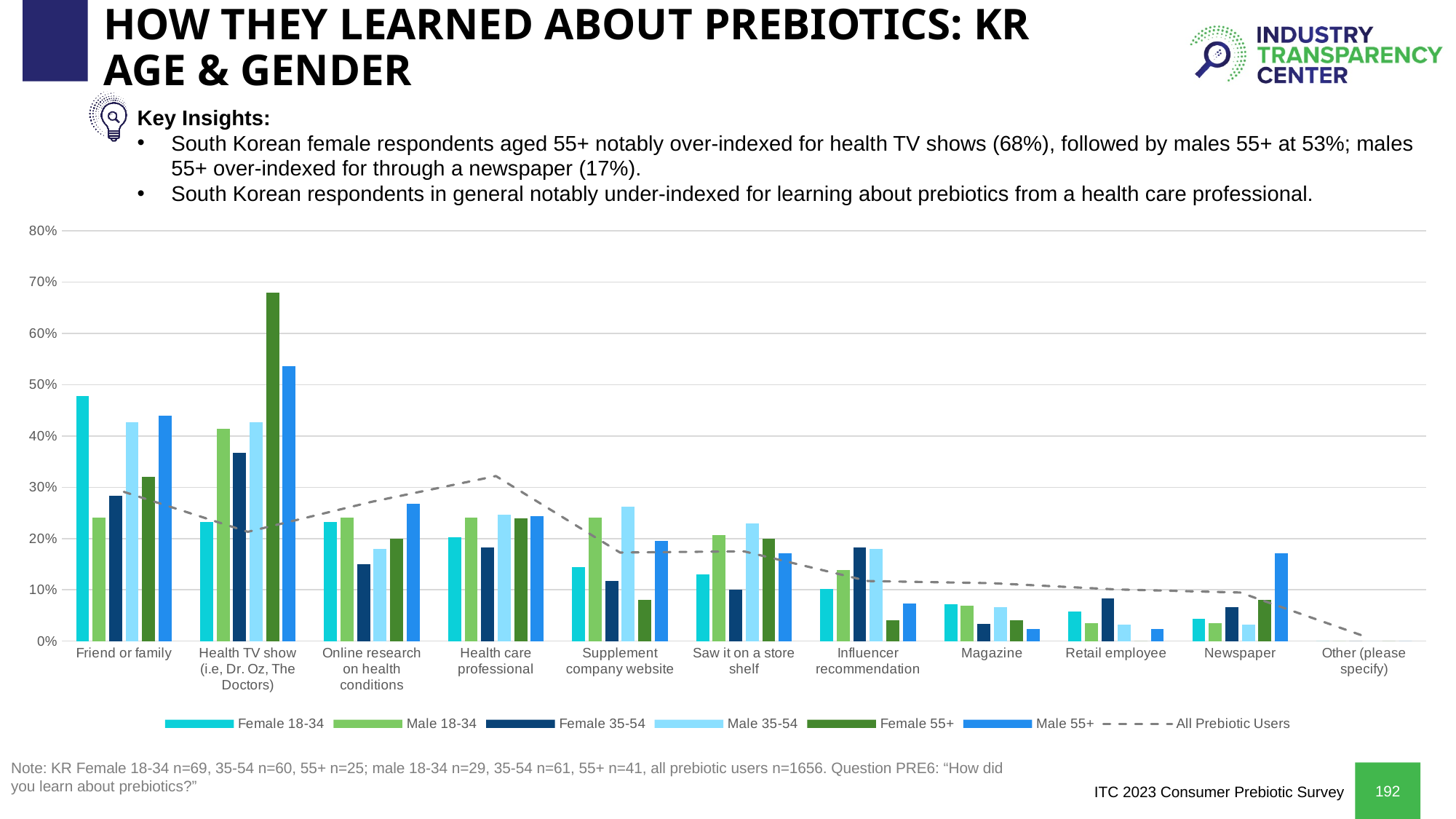
In which category is the Female 55+ bar highest? Health TV show (i.e, Dr. Oz, The Doctors) What is the value for Female 55+ in the Health TV show category? 68% Is the value for Female 18-34 in the Friend or family category greater or less than 40%? greater In which category is the Female 18-34 bar highest? Friend or family What is the value for Male 55+ in the Health TV show category? 53% What is the value for Male 55+ in the Newspaper category? 17% Which series is shown as a dashed line rather than bars? All Prebiotic Users How many series does the chart legend list? 7 In the Friend or family category, which is larger: the Female 18-34 bar or the Male 18-34 bar? Female 18-34 How many categories are shown along the x axis of the chart? 11 What kind of chart is shown on the slide? combination bar and line chart Is the value for Female 55+ in the Supplement company website category greater or less than 10%? less